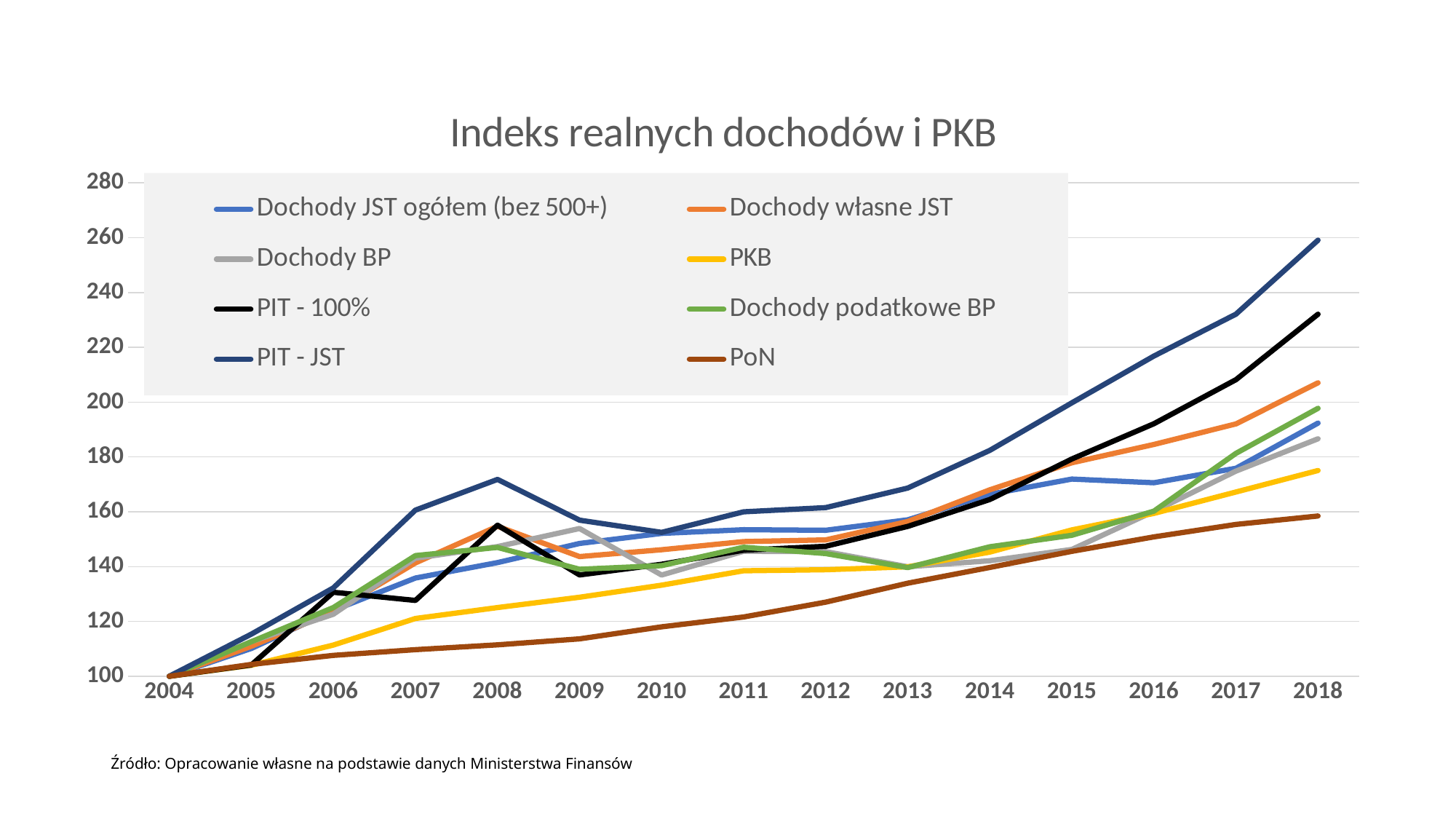
What is the value of PKB in 2004? 100 Is the value for PKB in 2018 greater or less than 160? greater How many series does the legend list? 8 In 2018, which is larger: Dochody własne JST or Dochody BP? Dochody własne JST Which series has the lowest value in 2018? PoN Is the value for PIT - JST in 2018 greater or less than 240? greater Does the PoN series rise or fall from 2004 to 2018? rises How many years are plotted along the x axis? 15 Is the value for PoN in 2018 greater or less than 180? less What is the title of the chart? Indeks realnych dochodów i PKB What kind of chart is shown on the slide? line chart Which series has the highest value in 2018? PIT - JST